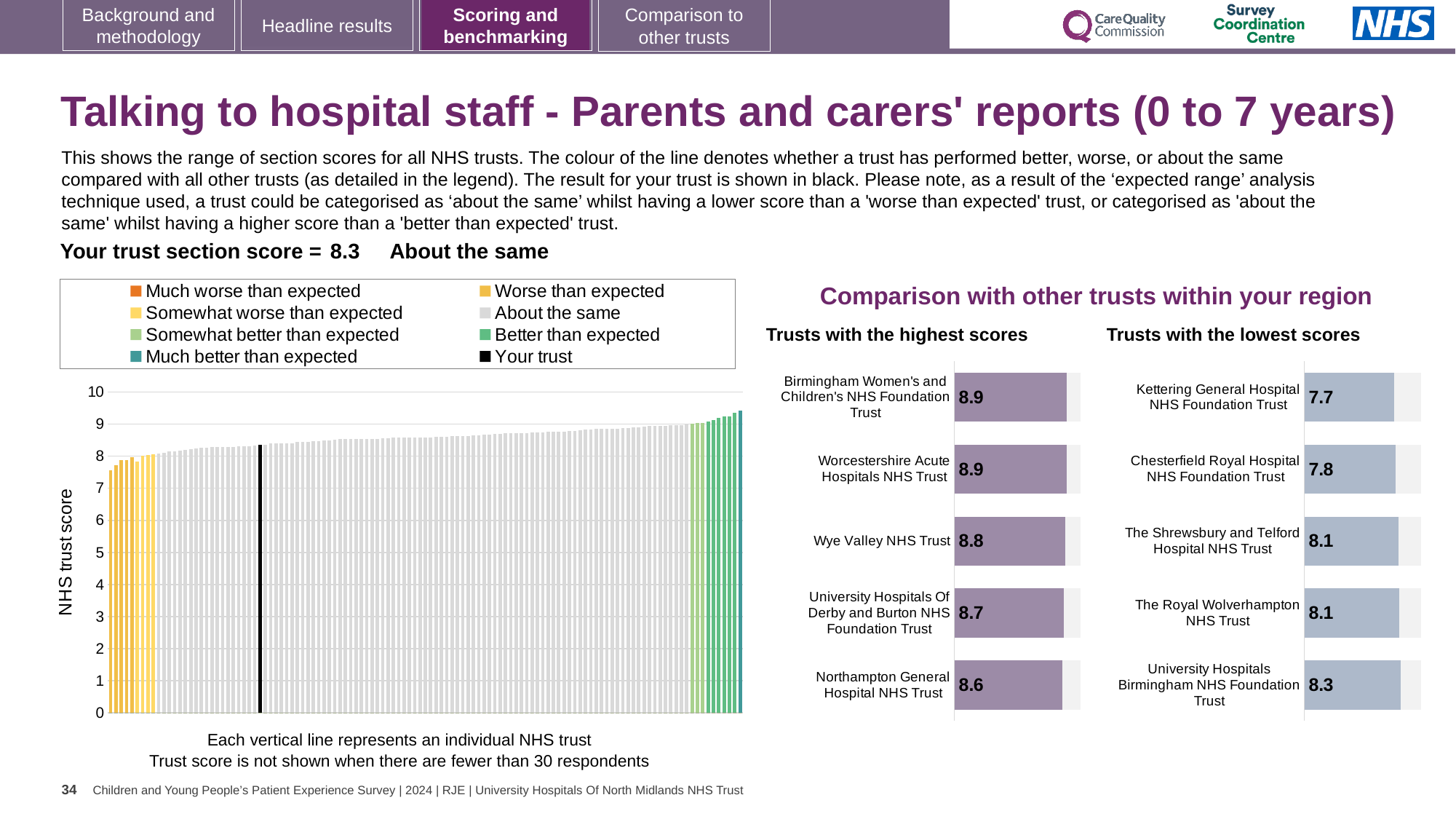
In the 'Trusts with the lowest scores' chart, what is the score for Kettering General Hospital NHS Foundation Trust? 7.7 How many entries does the legend above the large chart on the left list? 8 In the large chart on the left, is the value of the black bar (your trust) greater or less than 5? greater In the 'Trusts with the highest scores' chart, what is the score for Wye Valley NHS Trust? 8.8 In the 'Trusts with the lowest scores' chart, which has the larger score: Chesterfield Royal Hospital NHS Foundation Trust or The Shrewsbury and Telford Hospital NHS Trust? The Shrewsbury and Telford Hospital NHS Trust In the 'Trusts with the lowest scores' chart, which trust has the highest score? University Hospitals Birmingham NHS Foundation Trust What kind of chart is the large chart on the left showing NHS trust scores? Bar chart In the 'Trusts with the lowest scores' chart, what is the difference between the scores of University Hospitals Birmingham NHS Foundation Trust and Kettering General Hospital NHS Foundation Trust? 0.6 In the 'Trusts with the highest scores' chart, what is the difference between the scores of Birmingham Women's and Children's NHS Foundation Trust and Northampton General Hospital NHS Trust? 0.3 In the 'Trusts with the highest scores' chart, which trust has the lowest score? Northampton General Hospital NHS Trust In the large chart on the left, do the NHS trust scores rise or fall from left to right? Rise How many trusts are listed in the 'Trusts with the highest scores' chart? 5